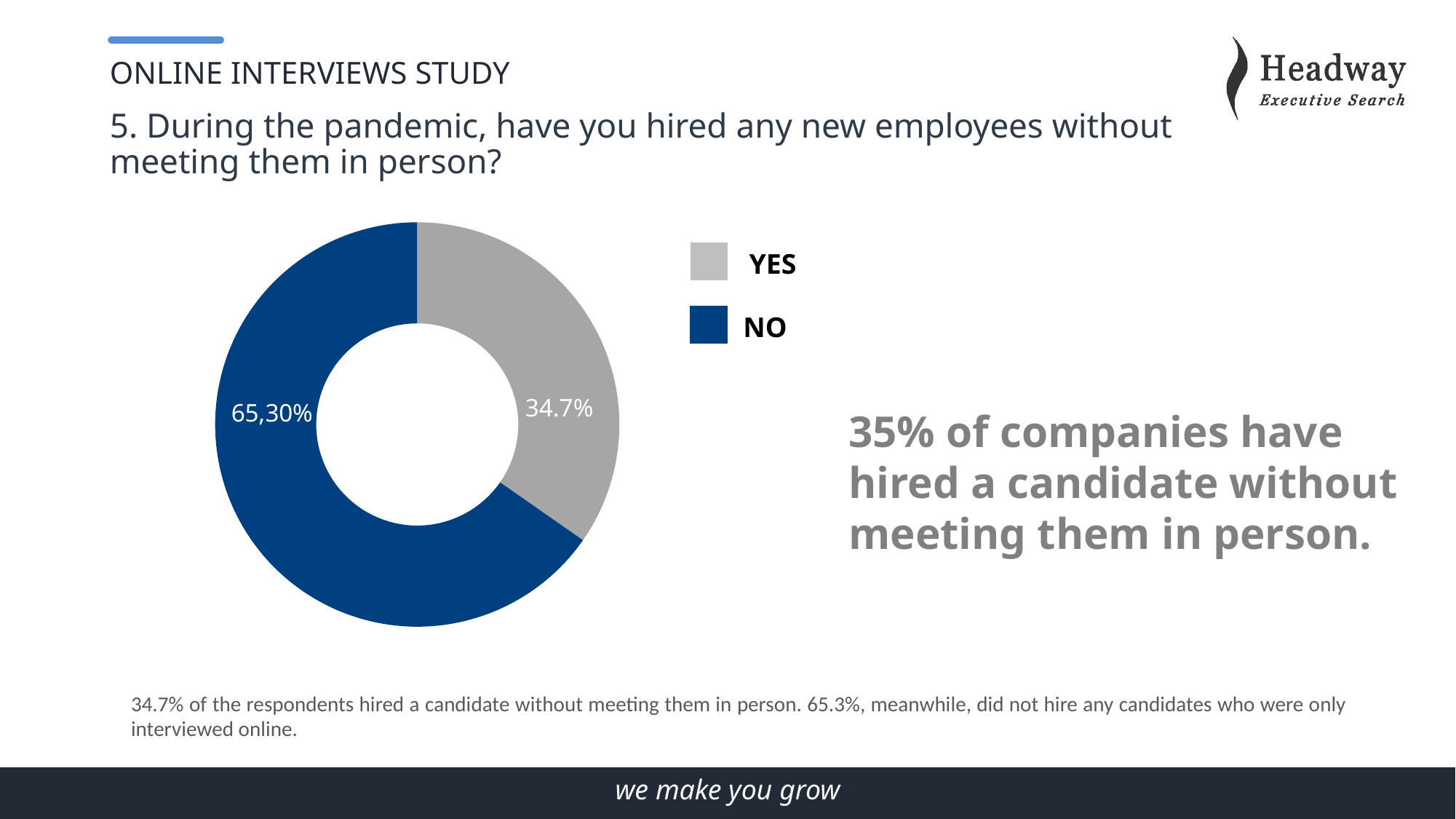
Is the share for YES larger or smaller than the share for NO? smaller What percentage of respondents answered YES? 34.7% How many entries does the legend list? 2 What kind of chart is shown on the slide? pie chart (doughnut) Which response has the smaller share of the chart? YES Which response has the larger share of the chart? NO How many categories does the chart show? 2 What is the difference in percentage points between the NO and YES shares? 30.6 What colour represents the NO response in the chart? dark blue What colour represents the YES response in the chart? grey What percentage of respondents answered NO? 65,30%